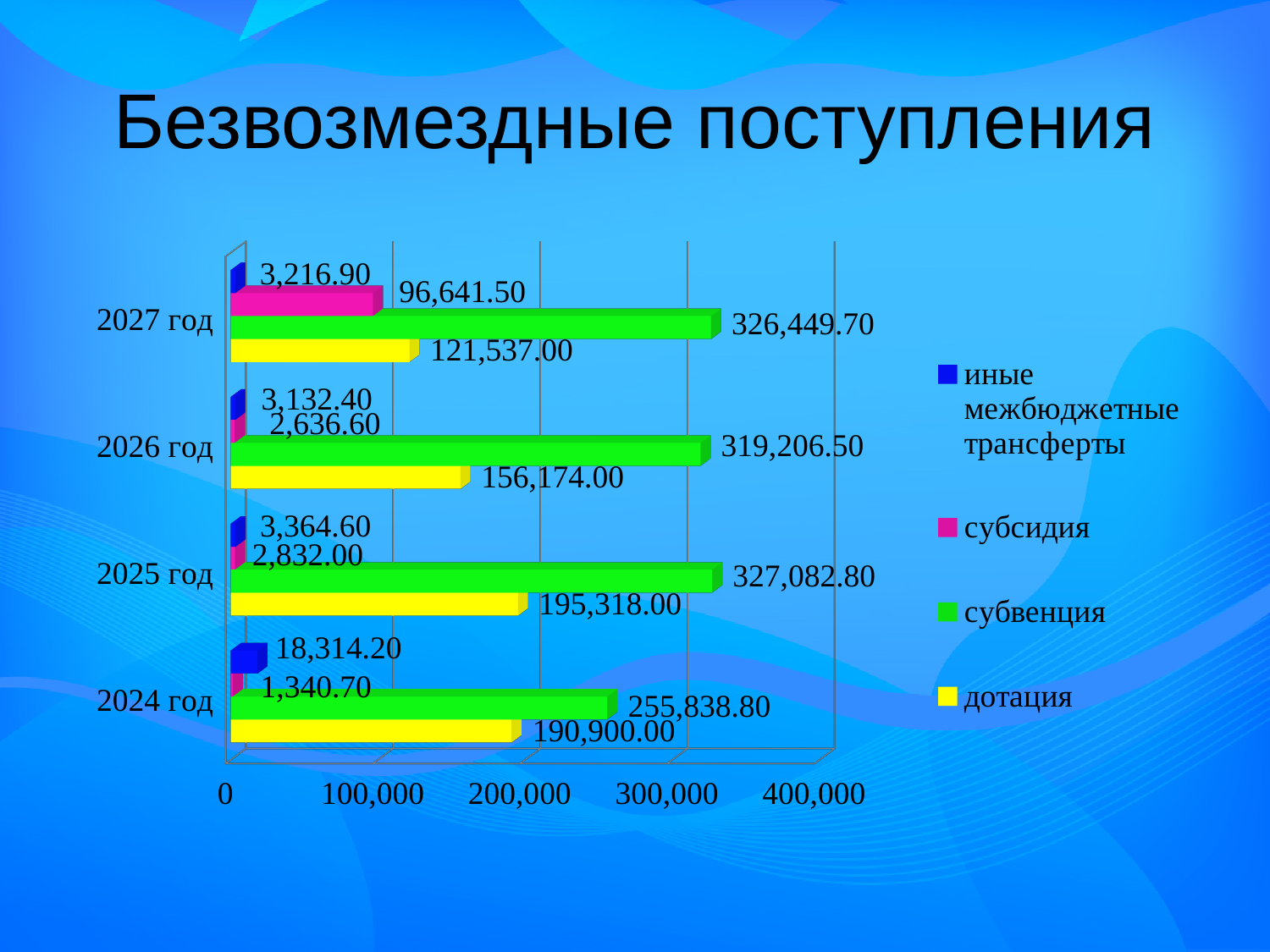
Which year has the lowest value for дотация? 2027 год What kind of chart is shown on the slide? bar chart What is the value of субвенция for 2027 год? 326,449.70 Which year has the highest value for субвенция? 2025 год How many years are shown on the chart? 4 What is the title of the chart? Безвозмездные поступления How many series does the legend list? 4 What is the value of иные межбюджетные трансферты for 2024 год? 18,314.20 What is the difference between дотация for 2025 год and дотация for 2027 год? 73,781.00 What is the value of дотация for 2025 год? 195,318.00 Which is larger: субвенция for 2024 год or субвенция for 2026 год? субвенция for 2026 год What is the value of субсидия for 2027 год? 96,641.50